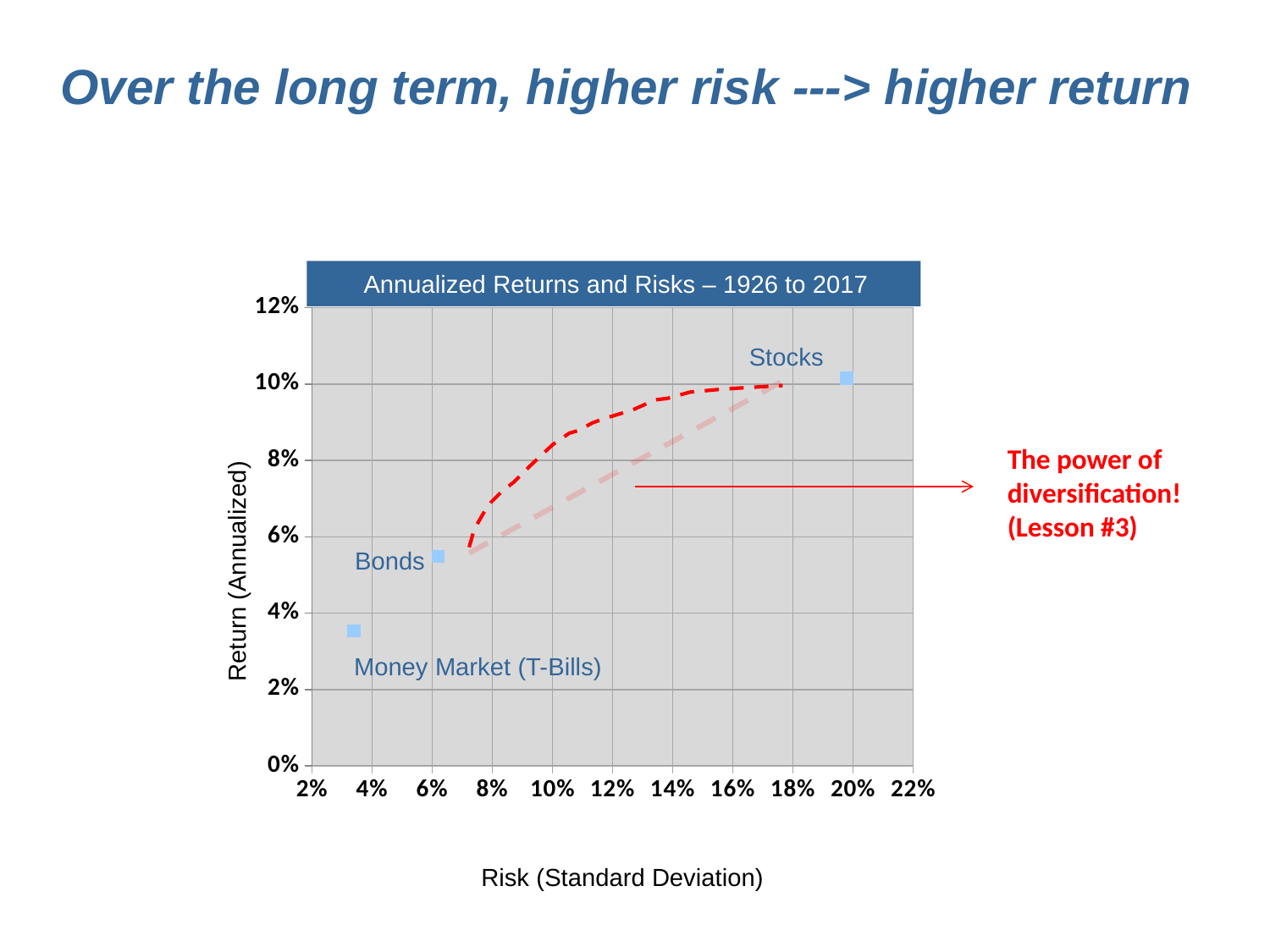
As risk increases along the x axis, do the annualized returns rise or fall? rise What is the title of the chart? Annualized Returns and Risks – 1926 to 2017 Which asset class has the lowest risk (standard deviation)? Money Market (T-Bills) Which asset class has the lowest annualized return? Money Market (T-Bills) Which has a higher annualized return, Bonds or Money Market (T-Bills)? Bonds Which asset class has the highest annualized return? Stocks Which asset class has the highest risk (standard deviation)? Stocks How many data points are plotted on the chart? 3 Is the annualized return for Bonds greater or less than 6%? less Is the risk (standard deviation) for Stocks greater or less than 18%? greater What kind of chart is shown on the slide? scatter chart